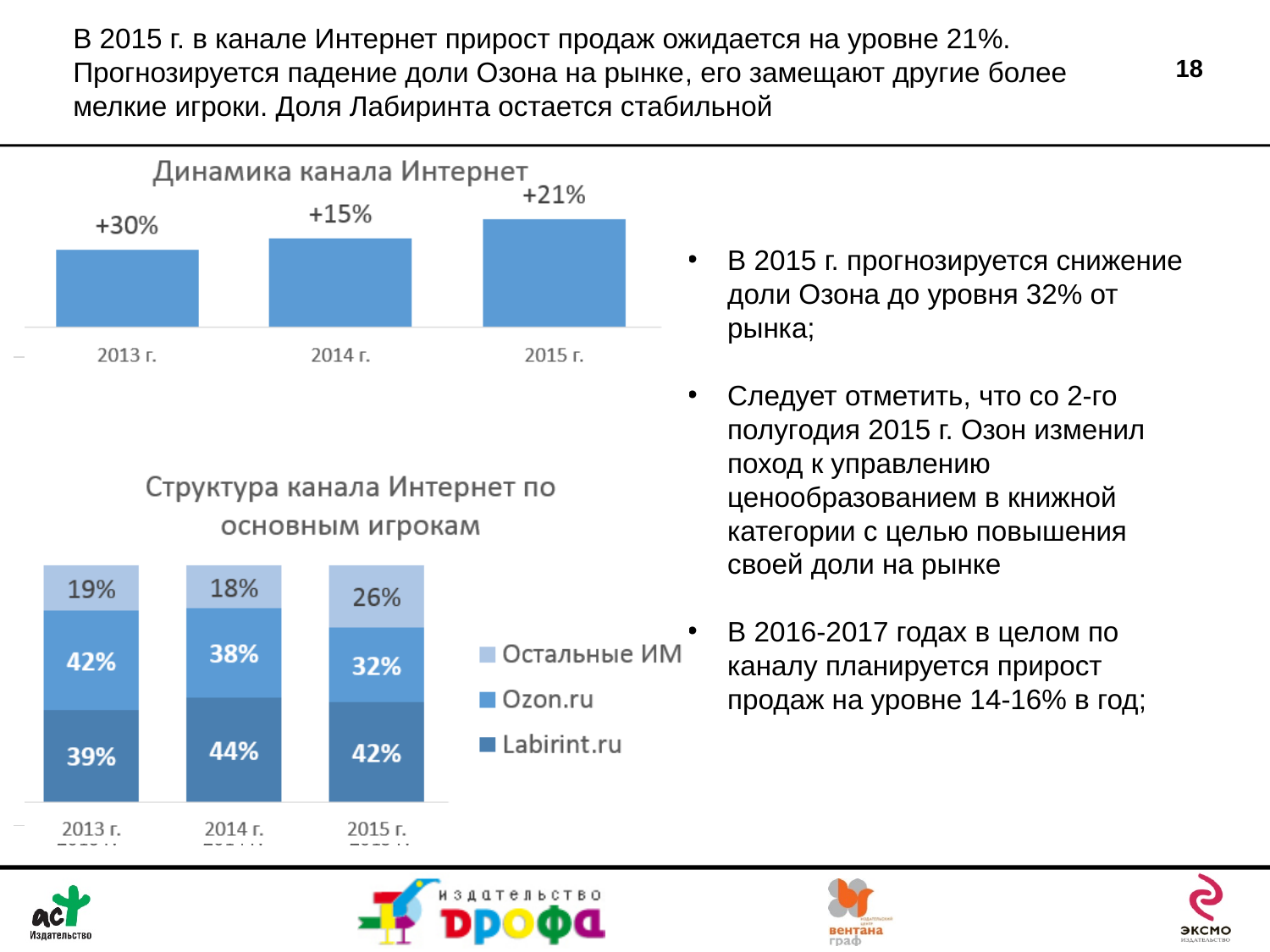
In the chart 'Структура канала Интернет по основным игрокам', how many series does the legend list? 3 In the chart 'Структура канала Интернет по основным игрокам', what is the difference between the Ozon.ru share in 2013 г. and in 2015 г.? 10% What type of chart is 'Динамика канала Интернет'? Bar chart In the chart 'Структура канала Интернет по основным игрокам', what is the share of Labirint.ru in 2014 г.? 44% In the chart 'Структура канала Интернет по основным игрокам', what is the share of Остальные ИМ in 2013 г.? 19% In the chart 'Динамика канала Интернет', what is the difference between the values for 2013 г. and 2014 г.? 15% In the chart 'Структура канала Интернет по основным игрокам', which is larger in 2013 г.: the share of Ozon.ru or the share of Labirint.ru? Ozon.ru In the chart 'Динамика канала Интернет', how many years are shown on the x axis? 3 In the chart 'Динамика канала Интернет', what is the value for 2015 г.? +21% In the chart 'Структура канала Интернет по основным игрокам', does the share of Ozon.ru rise or fall from 2013 г. to 2015 г.? Fall In the chart 'Динамика канала Интернет', what is the value for 2014 г.? +15% In the chart 'Структура канала Интернет по основным игрокам', what is the share of Ozon.ru in 2015 г.? 32%